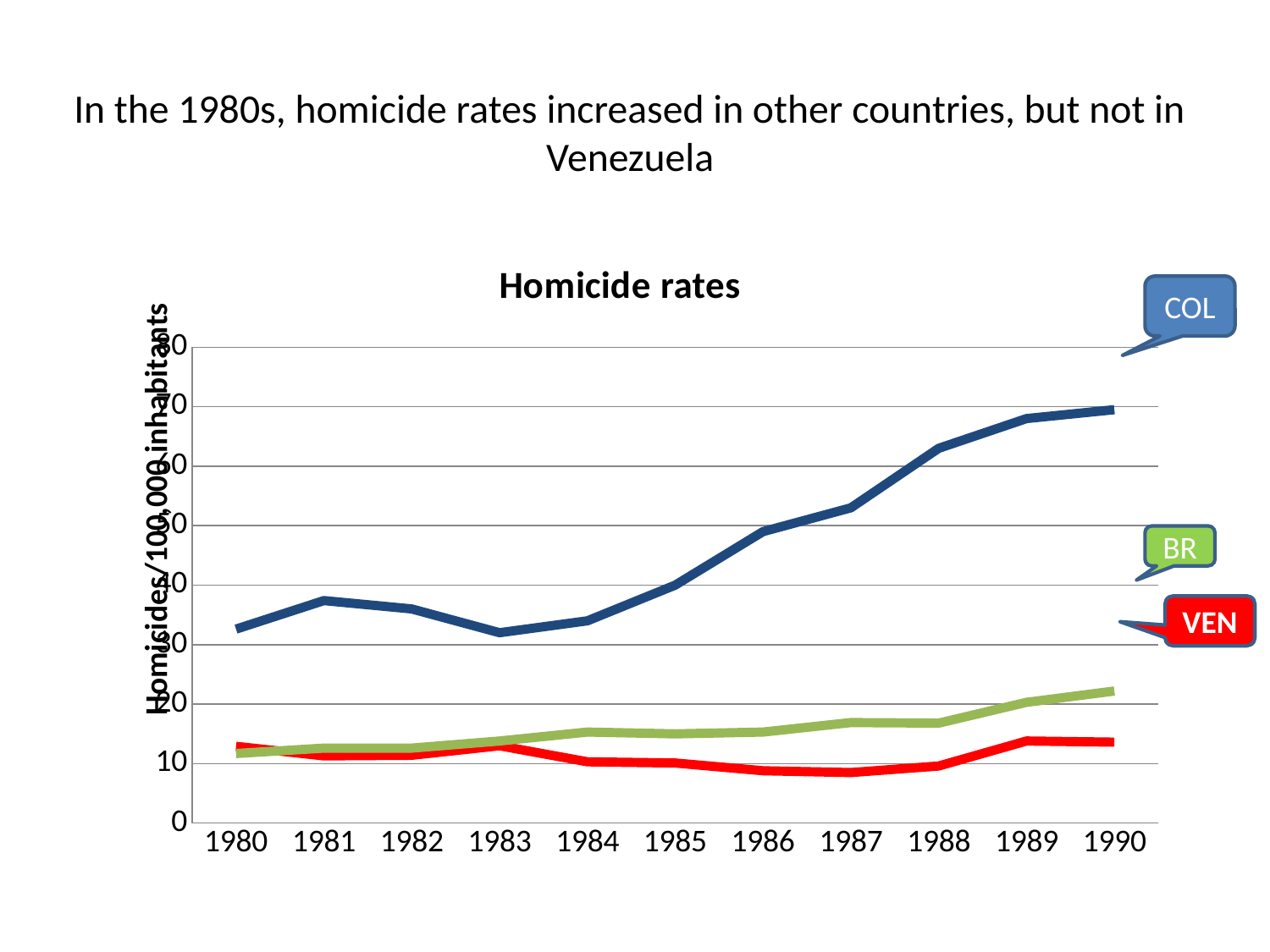
How many countries (lines) are plotted on the chart? 3 Which country has the highest homicide rate in 1990? COL Is the value for BR in 1990 greater or less than 20? greater Is the value for COL in 1990 greater or less than 60? greater How many years are shown along the x axis of the chart? 11 Which country has the lowest homicide rate in 1987? VEN What is the title of the chart? Homicide rates What kind of chart is shown on the slide? Line chart Is the value for COL in 1980 greater or less than 40? less Does the COL line rise or fall from 1983 to 1990? rise In 1990, which is larger, the value for COL or the value for VEN? COL